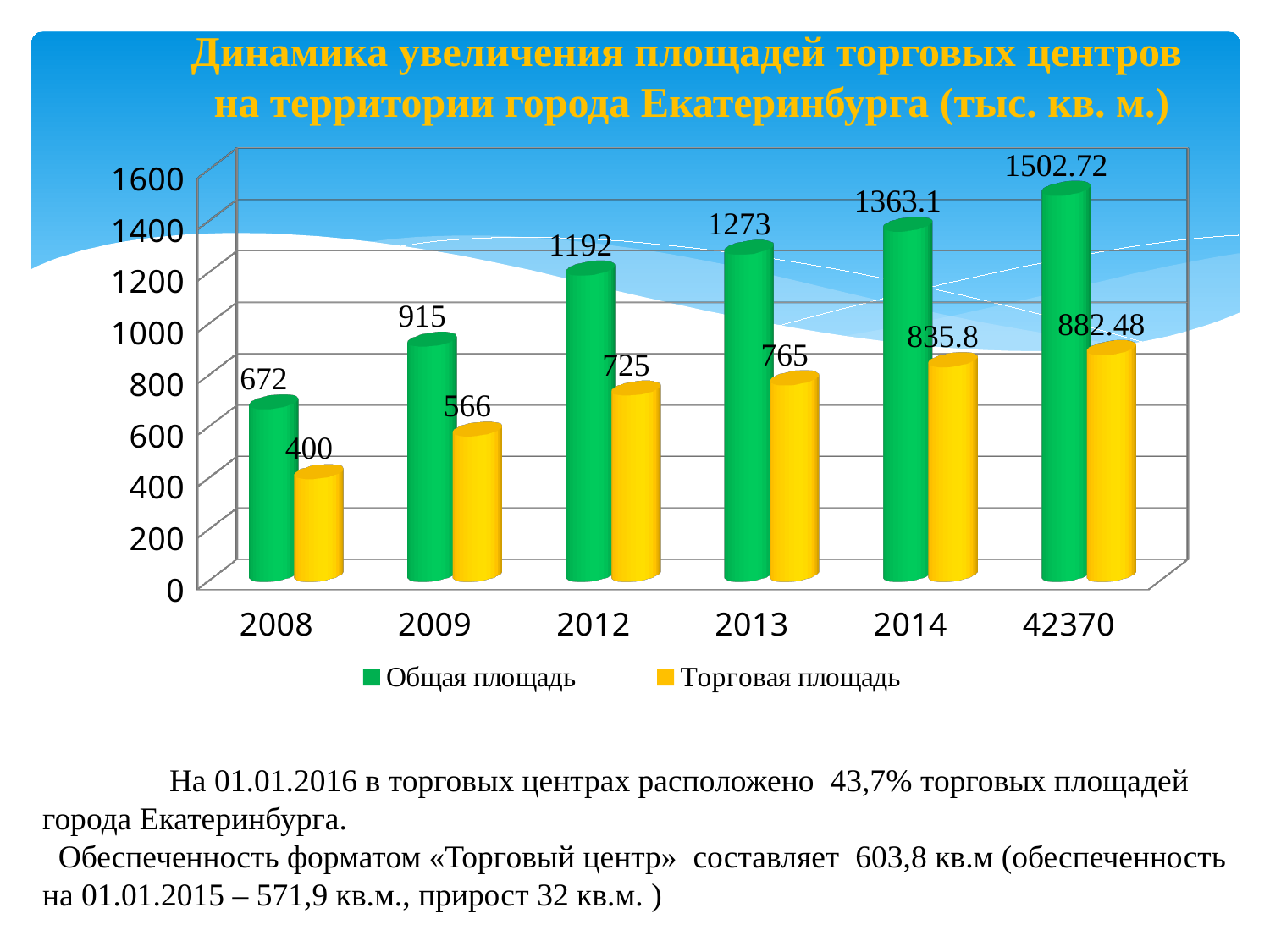
What kind of chart is shown on the slide? Bar chart Which category has the highest value for Общая площадь? 42370 What is the difference between Торговая площадь in 2009 and in 2008? 166 What is the value of Торговая площадь for 2014? 835.8 What is the value of Общая площадь for the category labelled 42370? 1502.72 How many series does the legend list? 2 How many categories are shown on the x axis? 6 Do the values for Общая площадь rise or fall from left to right along the x axis? Rise What is the value of Общая площадь for 2012? 1192 Which is larger: Общая площадь in 2009 or Торговая площадь in 2014? Общая площадь in 2009 Which category has the lowest value for Торговая площадь? 2008 What is the difference between Общая площадь and Торговая площадь in 2013? 508